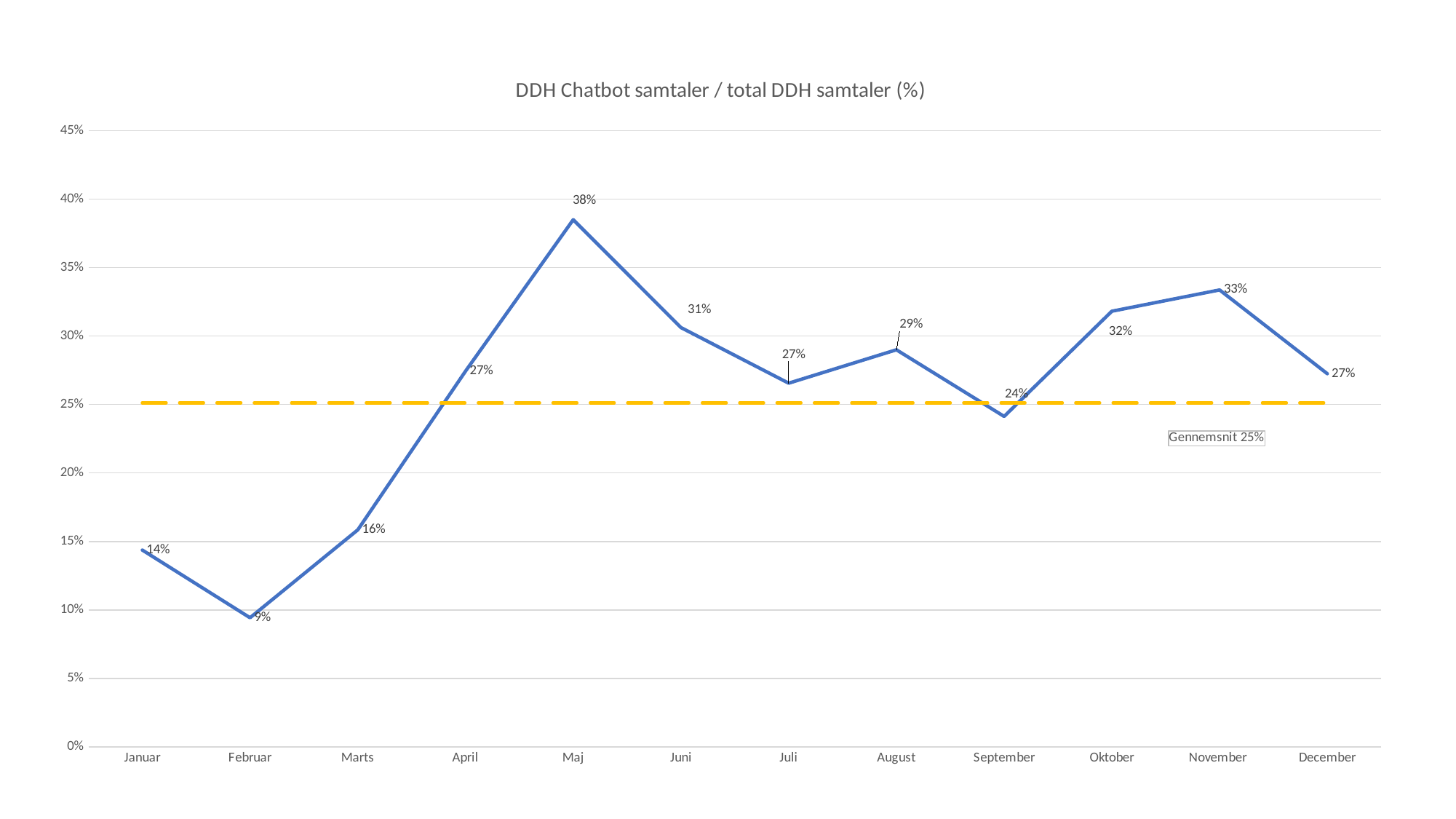
Is the value for September greater or less than 25%? less What is the value for Oktober? 32% What is the value for Maj? 38% What kind of chart is shown? line chart Which month has the lowest value? Februar What is the value for Februar? 9% Do the values rise or fall from Januar to Februar? fall What value does the dashed horizontal line labelled Gennemsnit represent? 25% Which is larger, the value for November or the value for December? November What is the difference between the values for Maj and Februar? 29% How many months are plotted on the x axis? 12 Which month has the highest value? Maj